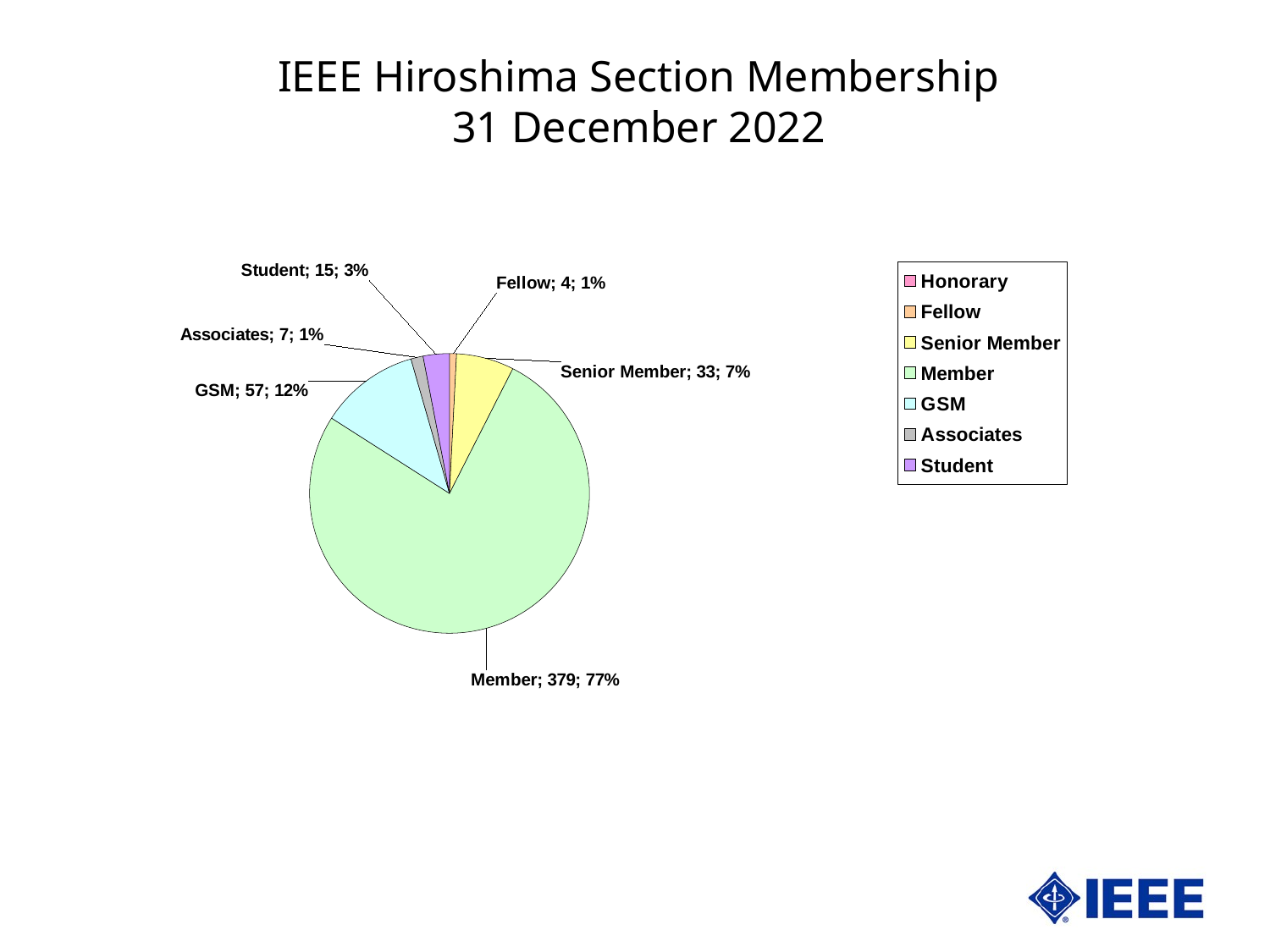
Which category has the smallest labelled slice of the pie? Fellow What kind of chart is shown on the slide? pie chart How many members are in the Member category? 379 What is the title of the slide containing the chart? IEEE Hiroshima Section Membership 31 December 2022 Which is larger, the Student count or the Associates count? Student What percentage of the pie is the Senior Member slice? 7% Which category has the largest slice of the pie? Member What is the difference between the number of GSM members and the number of Senior Members? 24 How many members are in the GSM category? 57 How many Fellows are shown on the chart? 4 What share of the pie does the Member slice represent? 77% How many entries does the legend list? 7